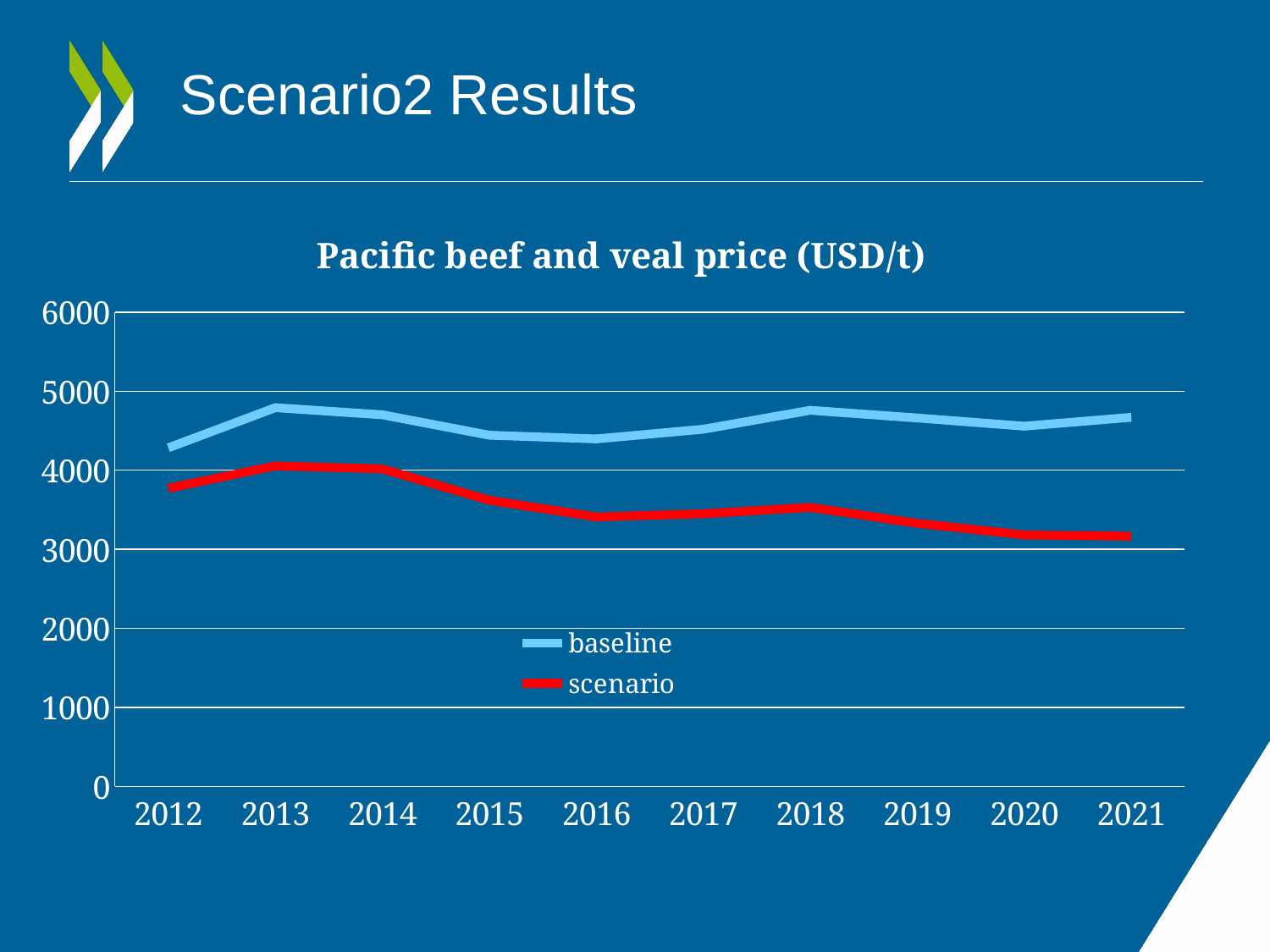
Is the baseline value for 2013 greater or less than 4000? greater How many series does the legend list? 2 In 2018, which series has the higher value, baseline or scenario? baseline Is the scenario value for 2021 greater or less than 4000? less What is the title of the chart? Pacific beef and veal price (USD/t) What kind of chart is shown on the slide? line chart Which colour is used for the scenario series? red Does the scenario series rise or fall from 2014 to 2021? fall How many years are shown on the x axis? 10 Is the baseline value for 2012 greater or less than 5000? less For the scenario series, which year has the higher value, 2013 or 2021? 2013